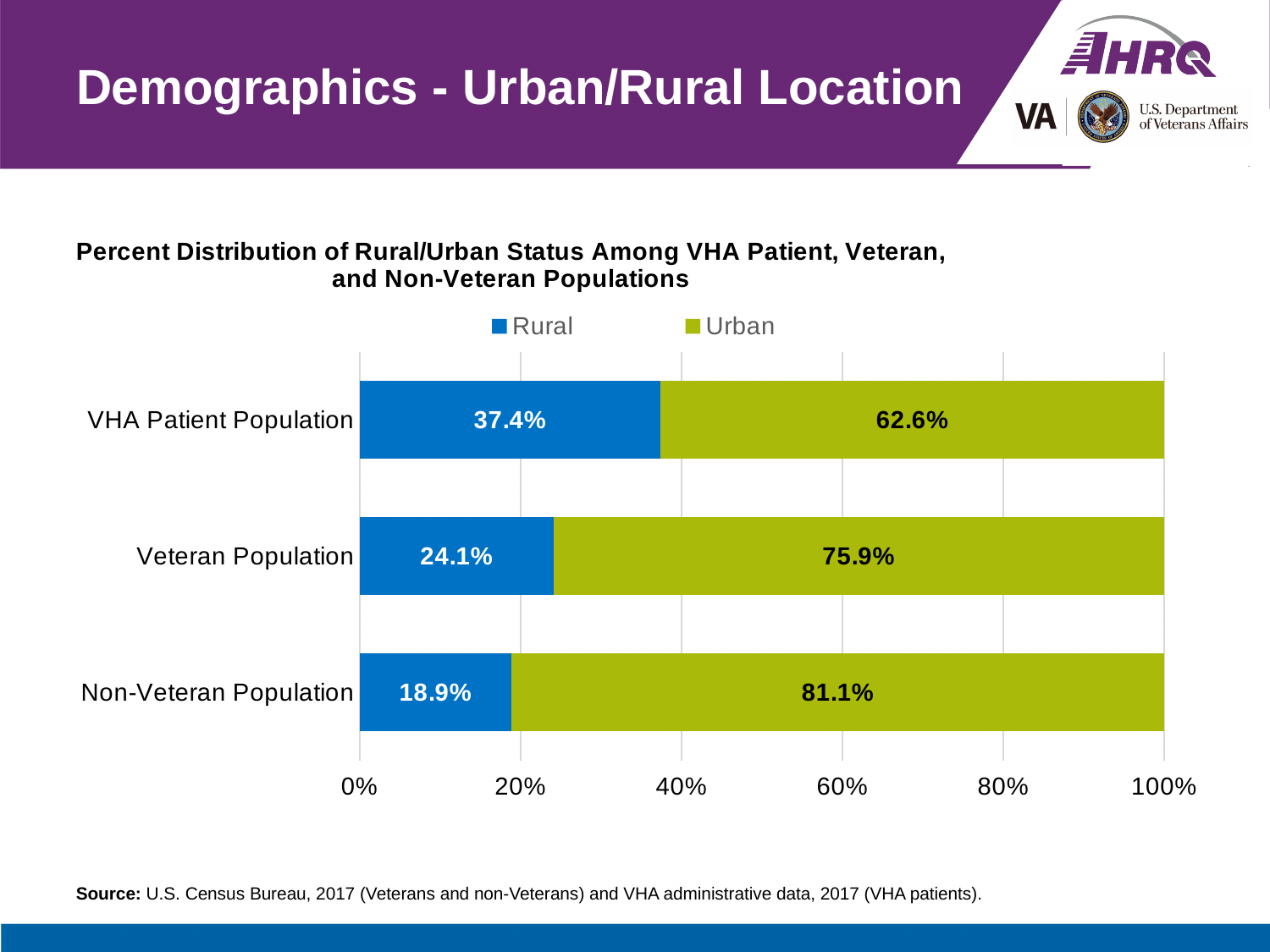
What is the difference between the Rural values for the VHA Patient Population and the Veteran Population? 13.3% Which population has the lowest Urban share? VHA Patient Population How many series does the legend list? 2 What is the Rural value for the VHA Patient Population? 37.4% What is the Rural value for the Non-Veteran Population? 18.9% What is the total of the stacked bar for the Non-Veteran Population? 100% Which is larger: the Urban value for the Non-Veteran Population or the Urban value for the Veteran Population? Non-Veteran Population What is the Urban value for the Veteran Population? 75.9% Is the Rural value for the Veteran Population greater or less than 20%? greater What kind of chart is shown on the slide? Stacked bar chart How many population categories are shown in the chart? 3 Which population has the highest Rural share? VHA Patient Population